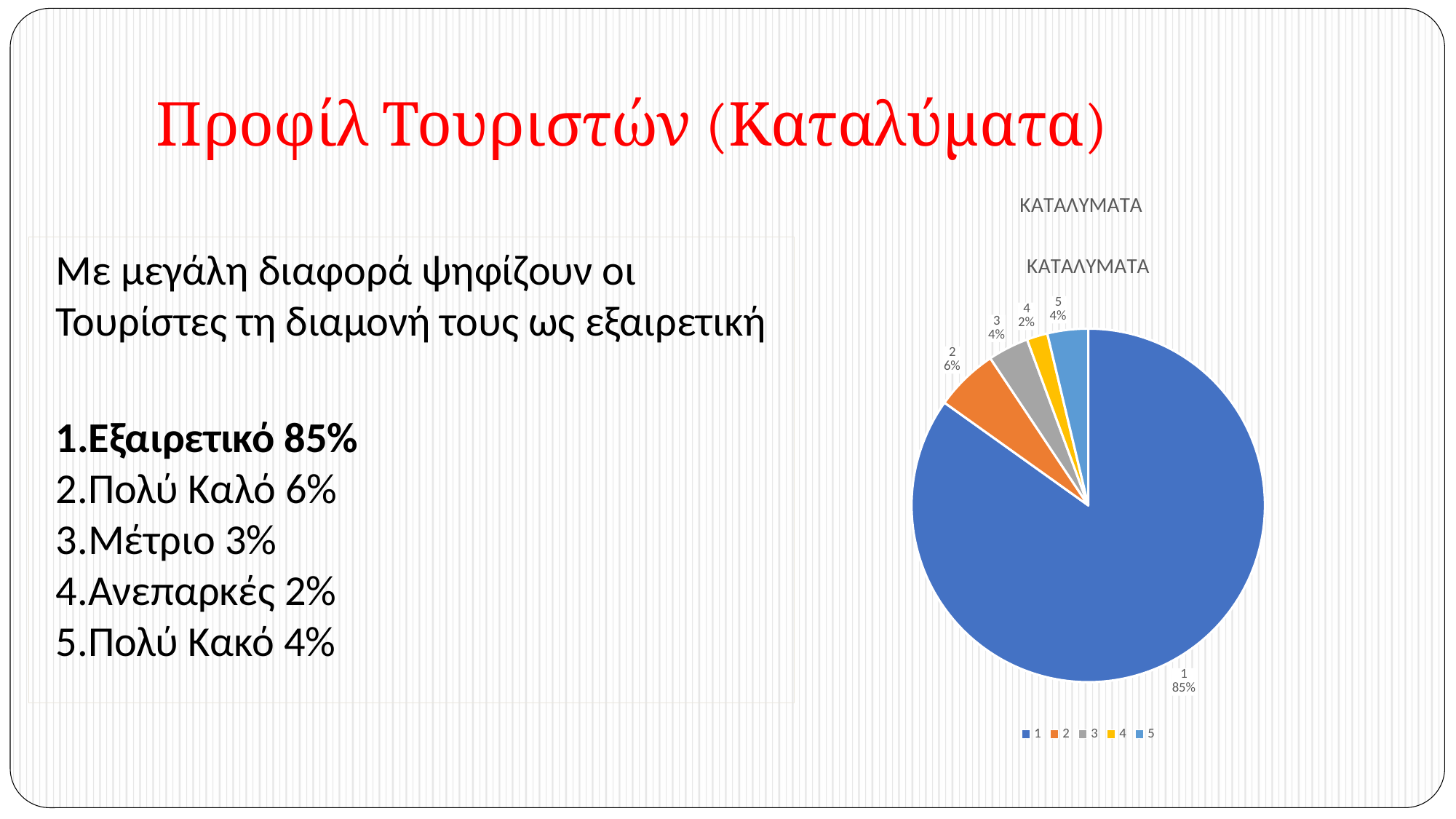
What percentage is shown for slice 4 in the pie chart? 2% How many entries does the legend list? 5 What percentage is shown for slice 5 in the pie chart? 4% Which slice has the largest share of the pie? 1 What is the title of the chart? ΚΑΤΑΛΥΜΑΤΑ Which is larger, slice 2 or slice 4? 2 How many slices does the pie chart have? 5 What percentage is shown for slice 1 in the pie chart? 85% What is the difference in percentage points between slice 1 and slice 2? 79 Which slice has the smallest share of the pie? 4 What type of chart is shown on the slide? pie chart What percentage is shown for slice 2 in the pie chart? 6%